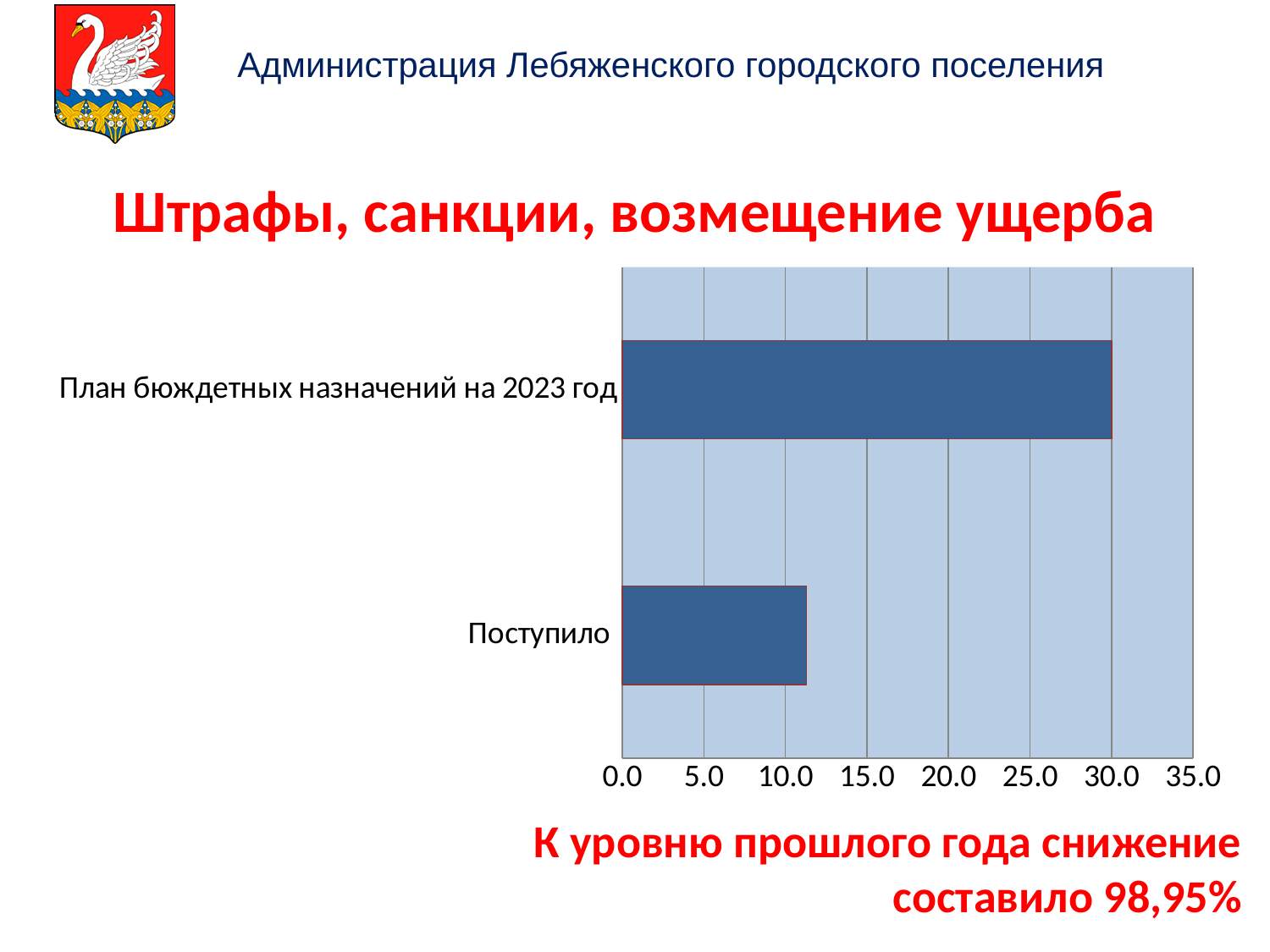
What is the value for План бюждетных назначений на 2023 год? 30.0 Which category has the lowest value? Поступило Is the value for Поступило greater or less than 15.0? less How many categories does the chart show? 2 Is the value for Поступило greater or less than 10.0? greater What is the title of the chart on the slide? Штрафы, санкции, возмещение ущерба Is the value for План бюждетных назначений на 2023 год greater or less than 25.0? greater Which is larger: the value for План бюждетных назначений на 2023 год or the value for Поступило? План бюждетных назначений на 2023 год What is the maximum value shown on the horizontal axis? 35.0 What kind of chart is shown on the slide? bar chart Which category has the highest value? План бюждетных назначений на 2023 год